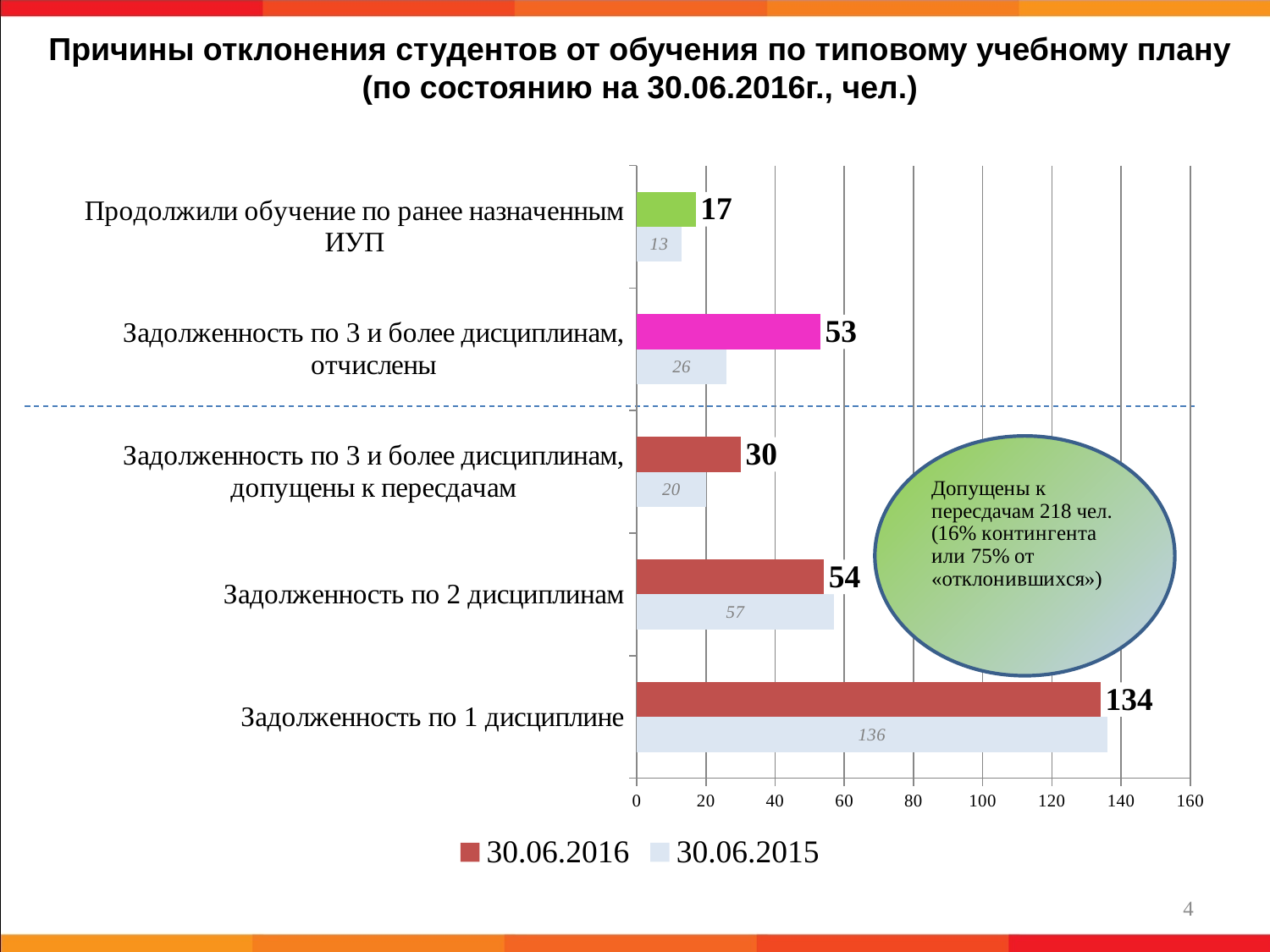
For "Задолженность по 2 дисциплинам", which series has the larger value, 30.06.2016 or 30.06.2015? 30.06.2015 What is the value for "Продолжили обучение по ранее назначенным ИУП" in the 30.06.2015 series? 13 How many categories are shown on the chart? 5 What is the value for "Задолженность по 3 и более дисциплинам, допущены к пересдачам" in the 30.06.2016 series? 30 What is the difference between the 30.06.2016 and 30.06.2015 values for "Задолженность по 3 и более дисциплинам, отчислены"? 27 What is the value for "Задолженность по 1 дисциплине" in the 30.06.2016 series? 134 What is the value for "Задолженность по 2 дисциплинам" in the 30.06.2015 series? 57 Which category has the lowest value in the 30.06.2015 series? Продолжили обучение по ранее назначенным ИУП What kind of chart is shown on the slide? Bar chart Which category has the highest value in the 30.06.2016 series? Задолженность по 1 дисциплине How many series does the legend list? 2 What is the value for "Задолженность по 3 и более дисциплинам, отчислены" in the 30.06.2016 series? 53